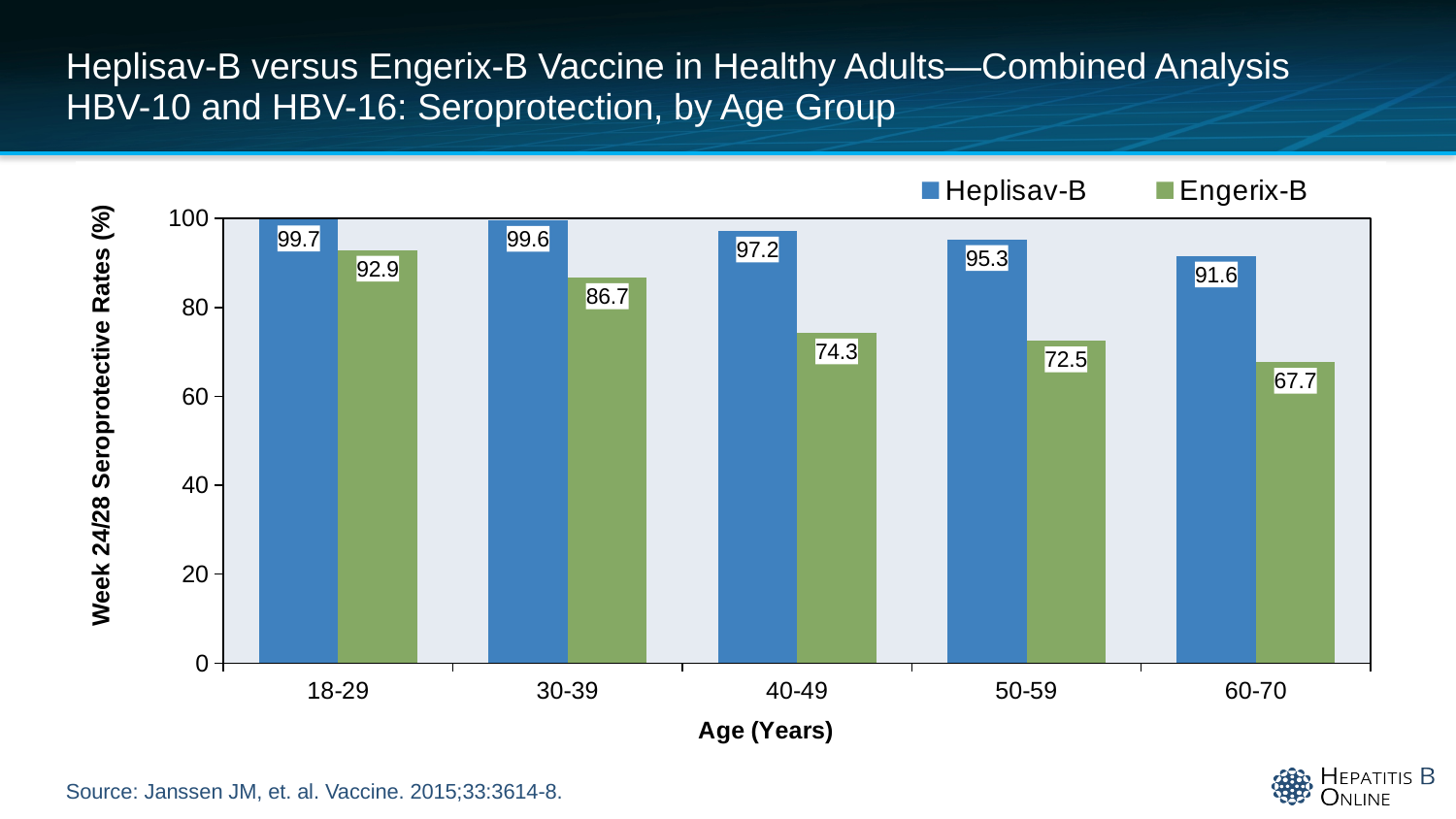
What kind of chart is shown on the slide? Bar chart Which is larger for the 30-39 age group, the Heplisav-B rate or the Engerix-B rate? Heplisav-B Which age group has the lowest Heplisav-B seroprotective rate? 60-70 How many age groups are shown on the x axis? 5 What is the Heplisav-B seroprotective rate for the 18-29 age group? 99.7 What is the Engerix-B seroprotective rate for the 60-70 age group? 67.7 Do the Engerix-B seroprotective rates rise or fall as age group increases along the x axis? Fall What is the Engerix-B value for the 40-49 age group? 74.3 What is the difference between the Heplisav-B and Engerix-B rates for the 50-59 age group? 22.8 How many series does the legend list? 2 Which age group has the highest Engerix-B seroprotective rate? 18-29 Is the Engerix-B value for the 60-70 age group greater or less than 80? less